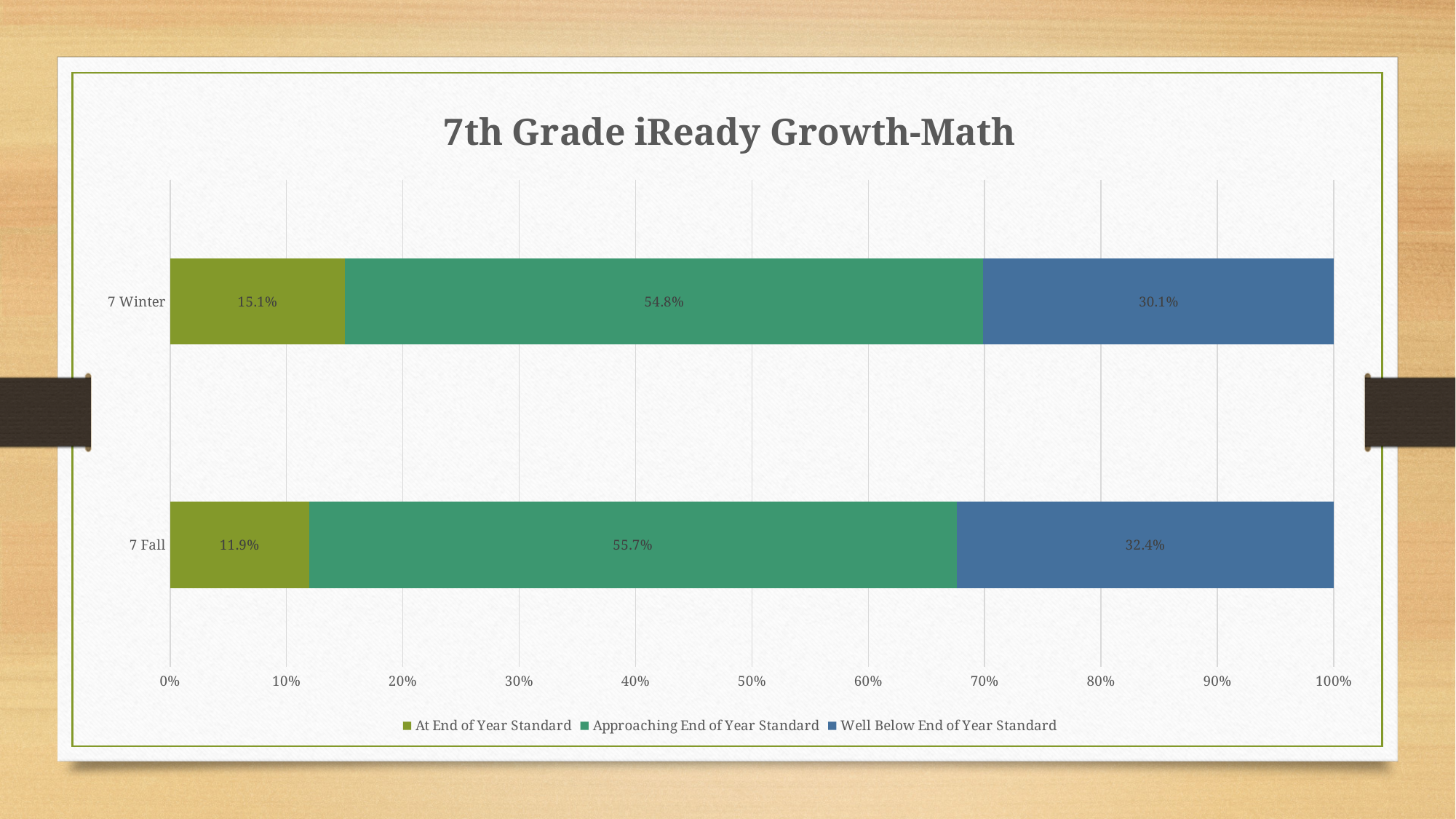
Which category has the higher value for At End of Year Standard, 7 Winter or 7 Fall? 7 Winter What is the value for Approaching End of Year Standard in 7 Fall? 55.7% What is the title of the chart? 7th Grade iReady Growth-Math What is the difference between the Well Below End of Year Standard values for 7 Fall and 7 Winter? 2.3% What is the value for Well Below End of Year Standard in 7 Winter? 30.1% What kind of chart is shown on the slide? Stacked bar chart What is the value for At End of Year Standard in 7 Winter? 15.1% How many series does the legend list? 3 What is the value for At End of Year Standard in 7 Fall? 11.9% Which category has the higher value for Well Below End of Year Standard, 7 Winter or 7 Fall? 7 Fall What is the difference between the At End of Year Standard values for 7 Winter and 7 Fall? 3.2% How many categories are shown on the chart? 2